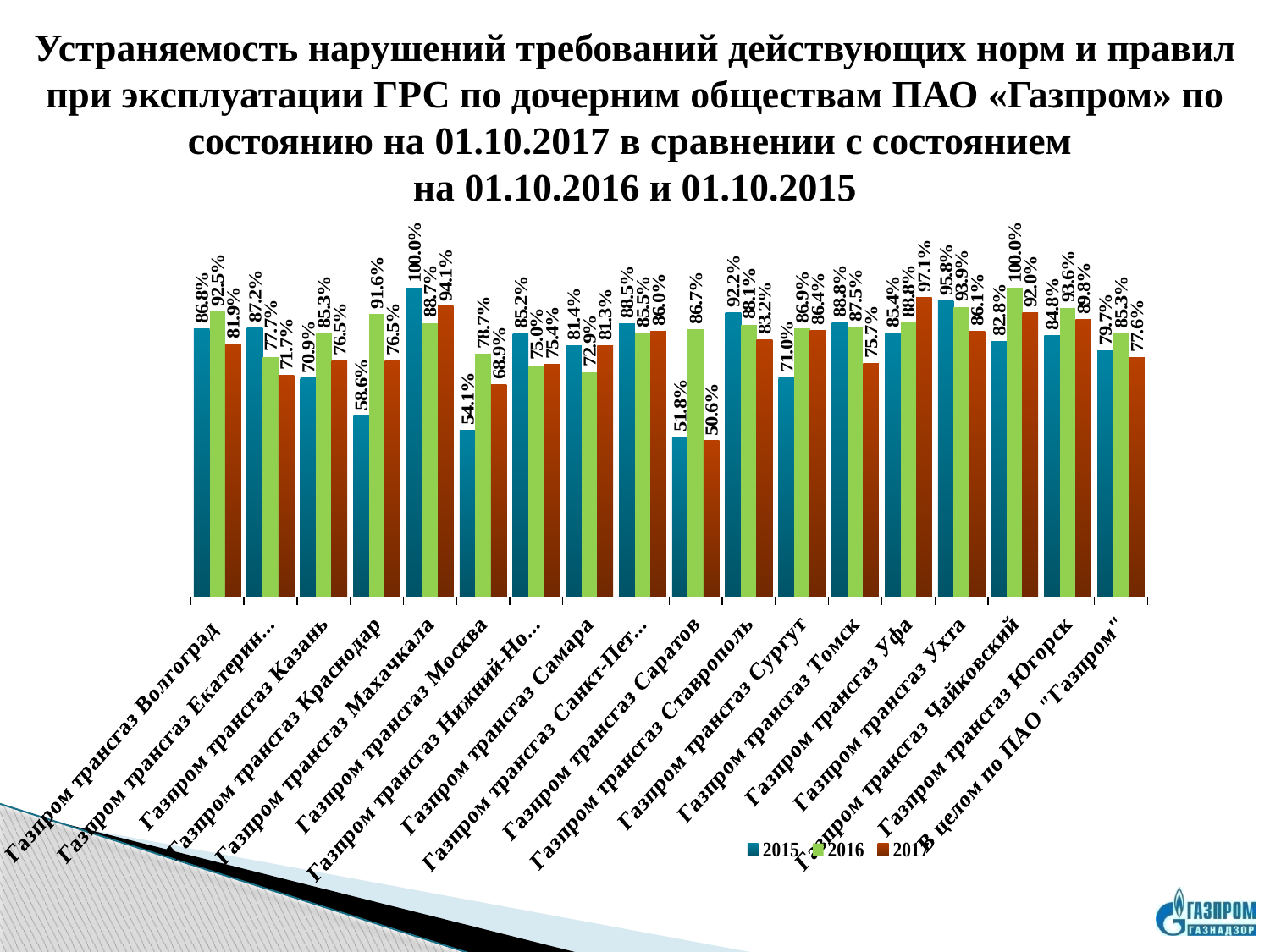
Which is larger for Газпром трансгаз Краснодар: the 2015 value or the 2016 value? 2016 What is the 2017 value for Газпром трансгаз Махачкала? 94.1% Which category has the highest 2016 value? Газпром трансгаз Чайковский Which category has the highest 2017 value? Газпром трансгаз Уфа Which category has the lowest 2015 value? Газпром трансгаз Саратов Which years are listed in the legend? 2015, 2016, 2017 How many series does the legend list? 3 What is the 2016 value for В целом по ПАО "Газпром"? 85.3% What is the 2015 value for Газпром трансгаз Саратов? 51.8% How many categories are shown on the x axis? 18 What is the difference between the 2016 and 2017 values for Газпром трансгаз Саратов? 36.1% What kind of chart is shown on the slide? Bar chart